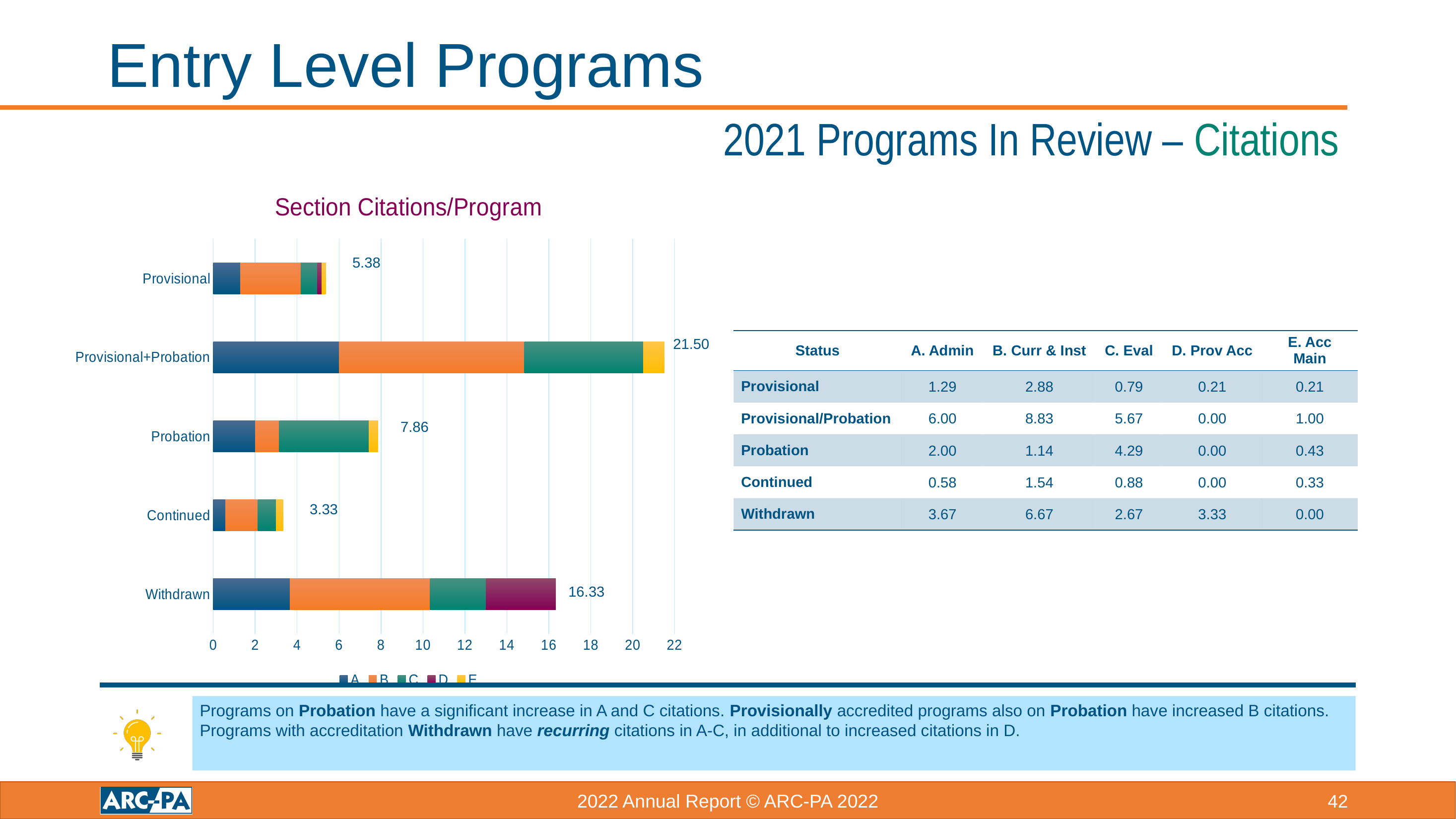
What is the total value shown for the Provisional+Probation bar? 21.50 Which category has the lowest total section citations per program? Continued What is the difference between the totals for Probation and Provisional? 2.48 What is the total of the stacked bar for Probation? 7.86 Which category has the highest total section citations per program? Provisional+Probation What is the difference between the totals for Provisional+Probation and Withdrawn? 5.17 What is the total value shown for the Withdrawn bar? 16.33 How many series does the chart legend list? 5 How many categories are shown on the chart? 5 What type of chart is shown on the slide? Stacked bar chart Which has a larger total, Probation or Provisional? Probation What is the total of the stacked bar for Continued? 3.33